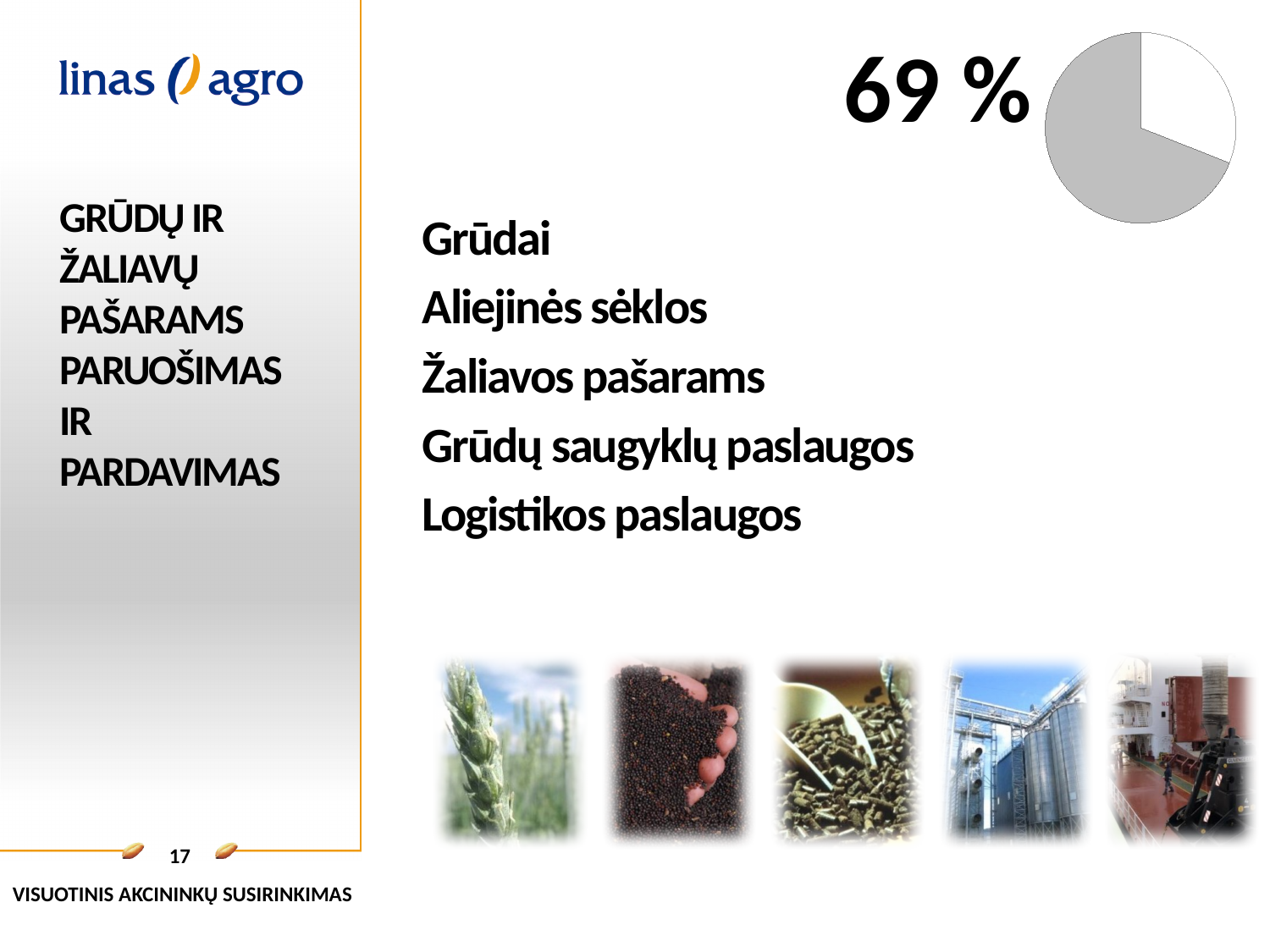
How many slices does the pie chart have? 2 What percentage is printed next to the pie chart? 69 % What share of the pie does the larger, gray slice represent? 69 % What two colours are used for the slices of the pie chart? gray and white Which slice of the pie chart is larger, the gray one or the white one? the gray one Which slice is the largest in the pie chart? the gray slice What kind of chart is shown in the top right corner of the slide? pie chart